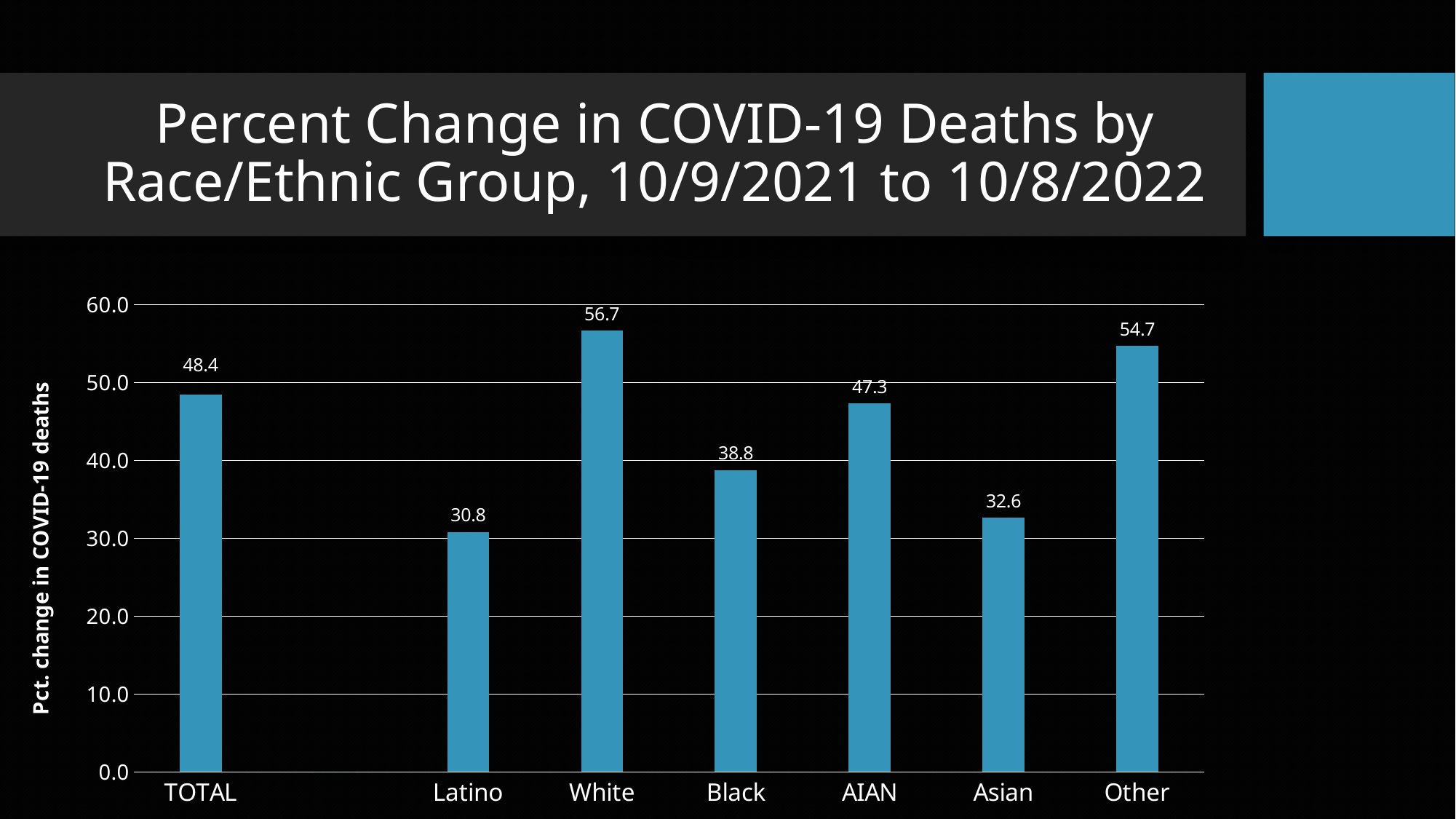
Which is larger, the value for AIAN or the value for Black? AIAN What is the percent change in COVID-19 deaths for the White group? 56.7 What is the percent change in COVID-19 deaths for the Asian group? 32.6 What is the difference between the values for Other and Black? 15.9 Is the value for Latino greater or less than 40.0? less What is the difference between the values for White and Latino? 25.9 How many bars are shown in the chart? 7 Which race/ethnic group has the lowest percent change in COVID-19 deaths? Latino What is the value shown for the TOTAL bar? 48.4 Which race/ethnic group has the highest percent change in COVID-19 deaths? White What is the label of the vertical axis? Pct. change in COVID-19 deaths What kind of chart is shown on the slide? bar chart